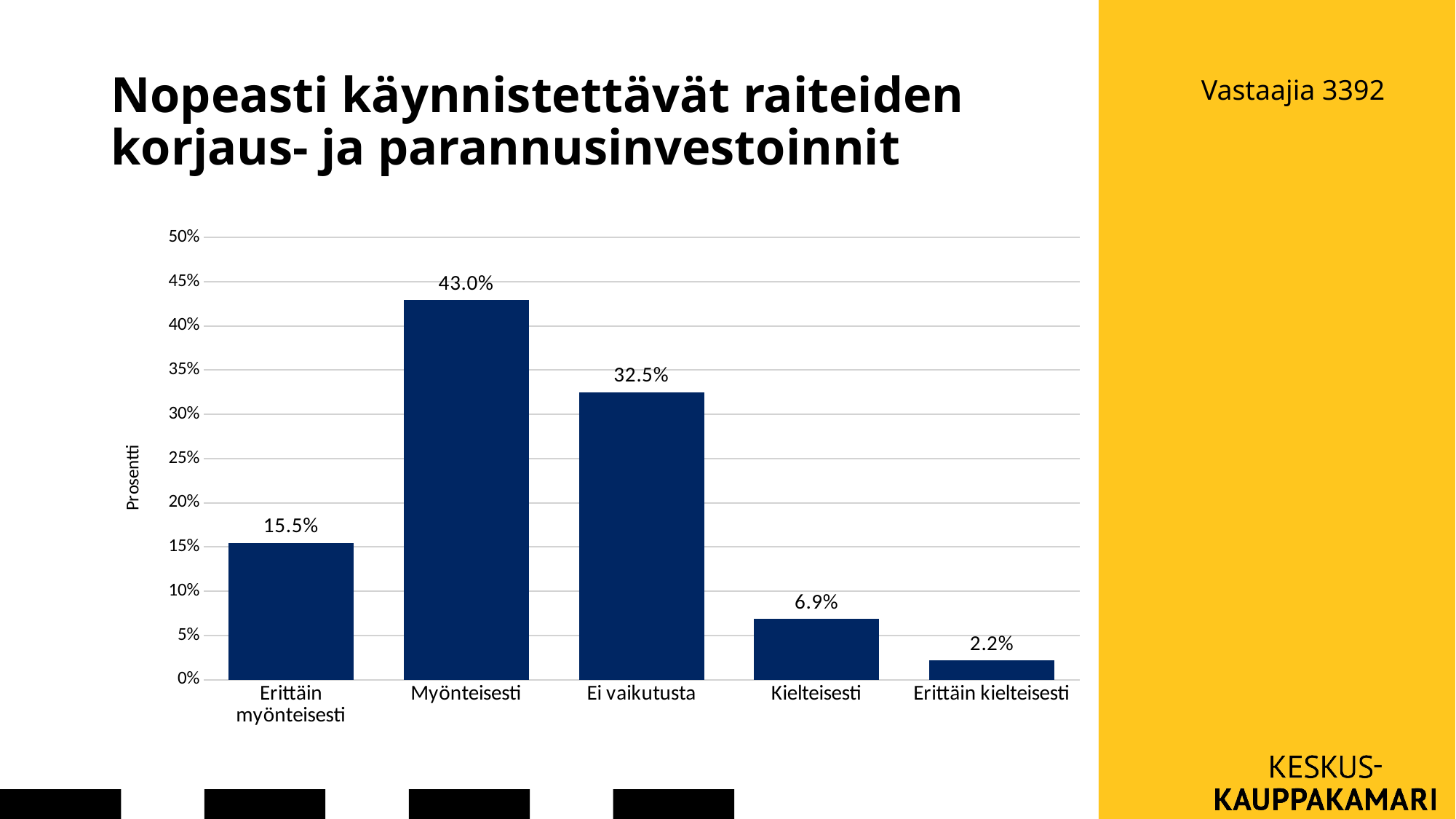
What is the value for Erittäin kielteisesti? 2.2% What kind of chart is shown on the slide? bar chart Which category has the highest value? Myönteisesti How many categories are shown on the x axis? 5 What is the difference between the values for Kielteisesti and Erittäin kielteisesti? 4.7% What is the difference between the values for Myönteisesti and Ei vaikutusta? 10.5% Which is larger, the value for Erittäin myönteisesti or the value for Kielteisesti? Erittäin myönteisesti Which category has the lowest value? Erittäin kielteisesti Is the value for Ei vaikutusta greater or less than 30%? greater What is the label of the vertical axis? Prosentti What is the value for Erittäin myönteisesti? 15.5% What is the value for Myönteisesti? 43.0%